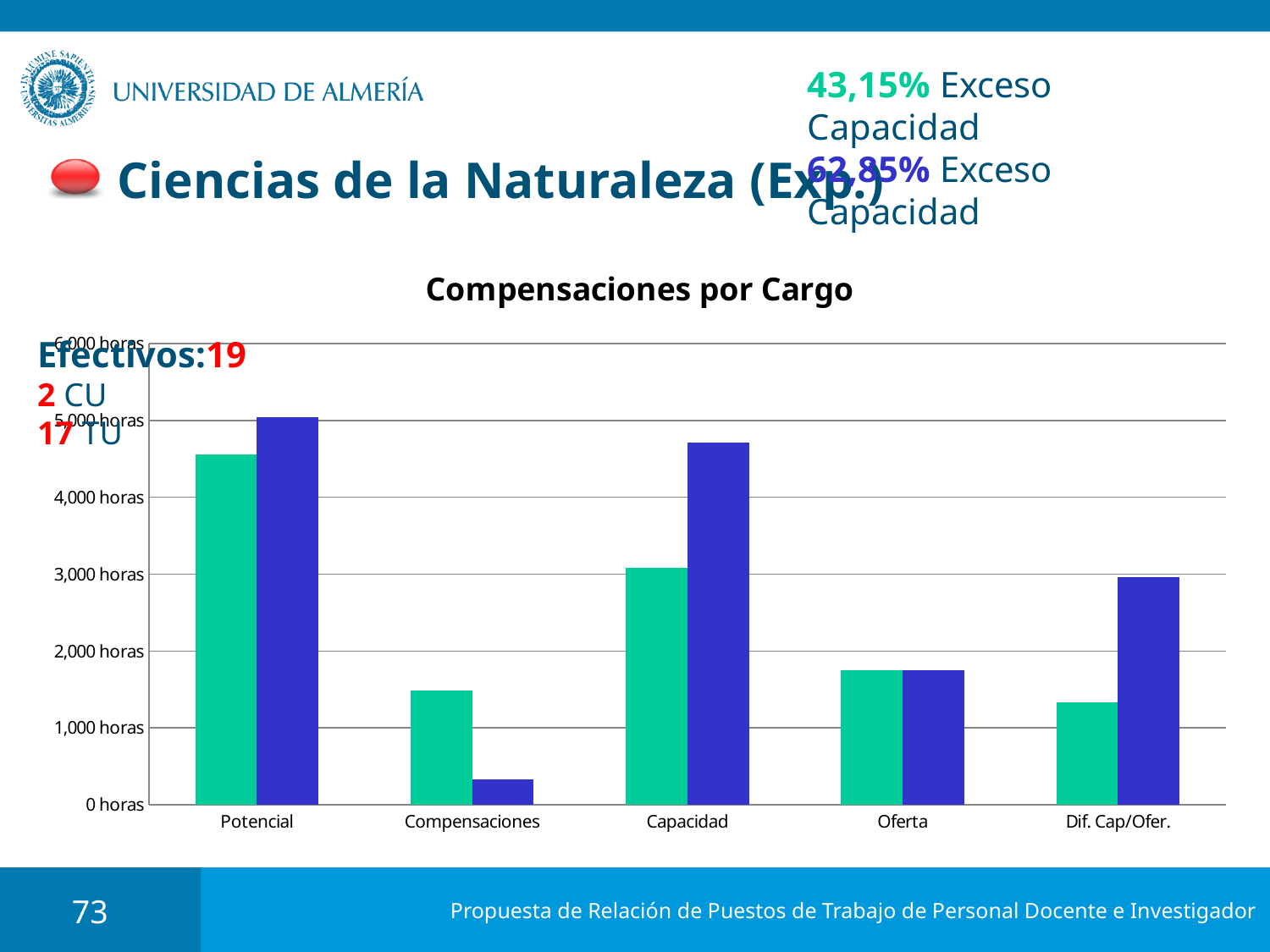
Is the value of the blue bar for Compensaciones greater or less than 1,000 horas? less For Compensaciones, which bar is larger, the green one or the blue one? green Which category has the tallest green bar? Potencial Is the value of the green bar for Potencial greater or less than 4,000 horas? greater What kind of chart is shown on the slide? bar chart What is the title of the chart? Compensaciones por Cargo Is the value of the blue bar for Capacidad greater or less than 4,000 horas? greater For Capacidad, which bar is larger, the green one or the blue one? blue Which category has the tallest blue bar? Potencial Which category has the shortest blue bar? Compensaciones How many categories are shown on the x axis of the chart? 5